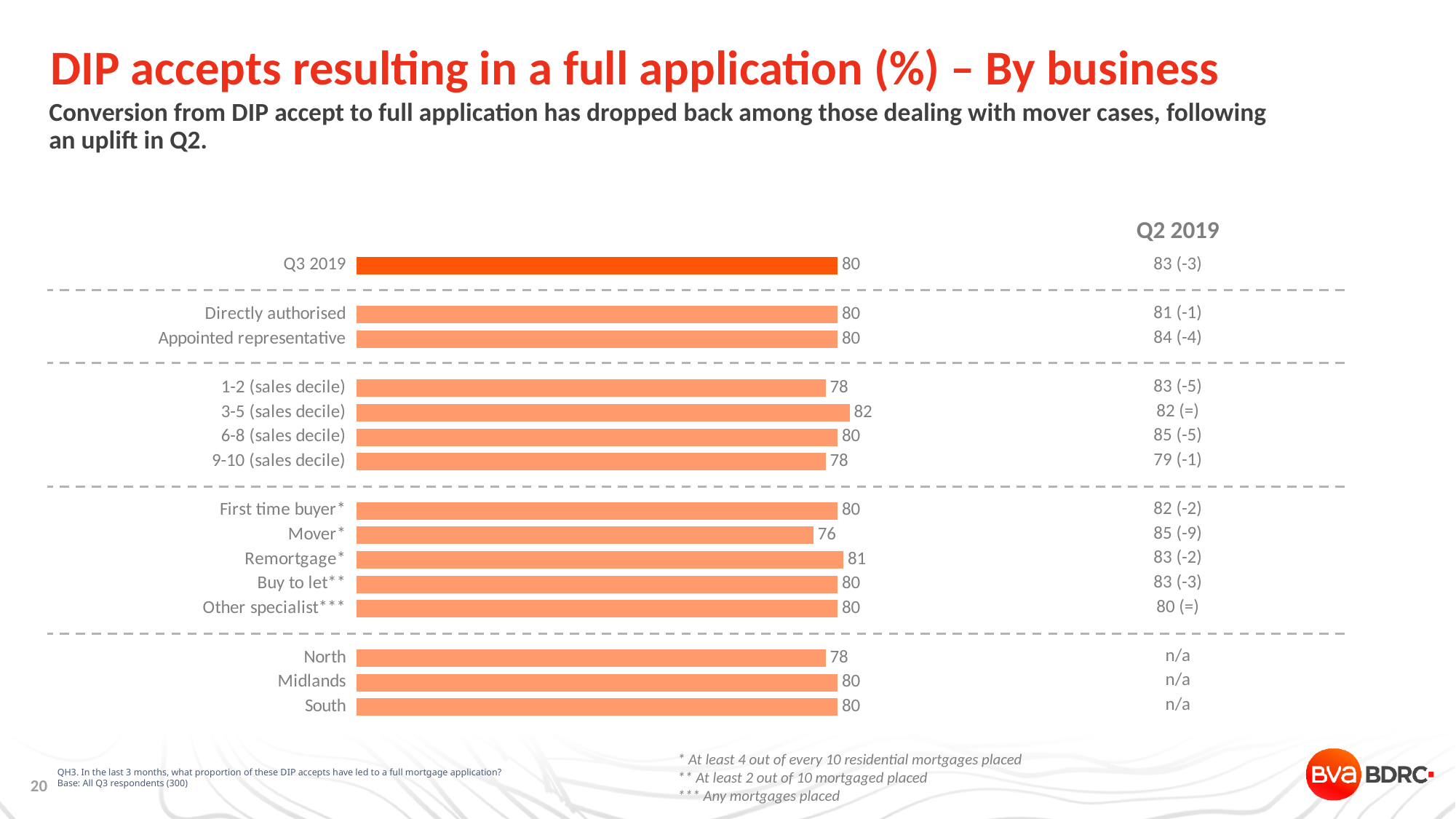
What is the difference between the values for Remortgage* and 1-2 (sales decile)? 3 How many bars are plotted in the chart? 16 What is the value for Mover* in the chart? 76 Which category has the highest value in the chart? 3-5 (sales decile) What is the value for 3-5 (sales decile)? 82 What Q2 2019 value is shown next to the Mover* bar? 85 (-9) What is the value for North? 78 Which is larger, the value for First time buyer* or the value for Mover*? First time buyer* What is the difference between the values for 3-5 (sales decile) and Mover*? 6 What kind of chart is shown on the slide? Bar chart What is the value for Remortgage*? 81 Which category has the lowest value in the chart? Mover*